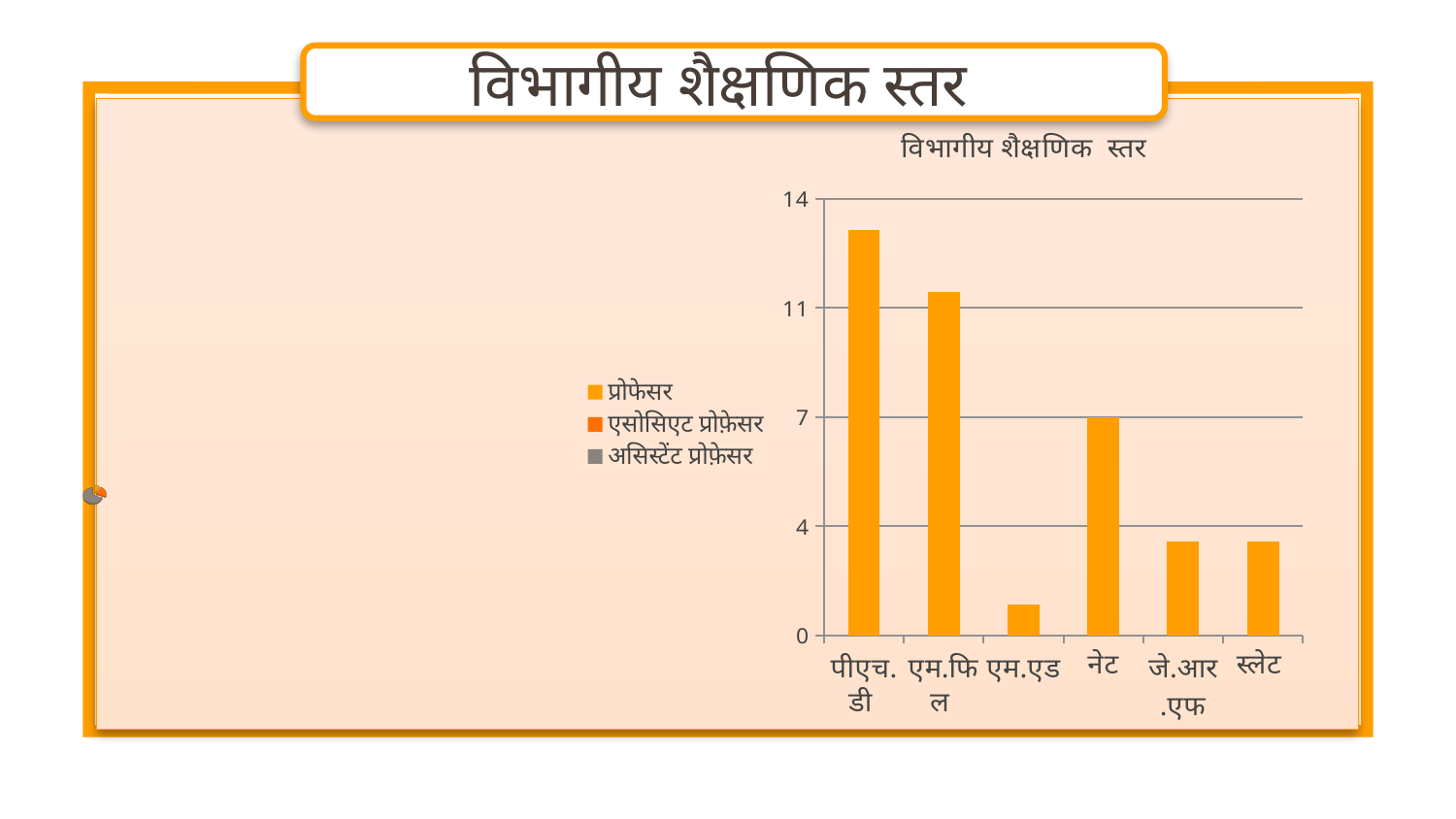
What is the value for नेट in the chart? 7 Which is larger, the value for पीएच.डी or the value for एम.फिल? पीएच.डी Do the values rise or fall from पीएच.डी to एम.एड along the x axis? fall Which category has the highest bar in the chart? पीएच.डी Is the value for पीएच.डी greater or less than 11? greater Is the value for जे.आर.एफ greater or less than 4? less What is the title of the chart? विभागीय शैक्षणिक स्तर What kind of chart is shown on the slide? bar chart Is the value for एम.एड greater or less than 4? less How many categories are shown on the x axis of the chart? 6 Which category has the lowest bar in the chart? एम.एड